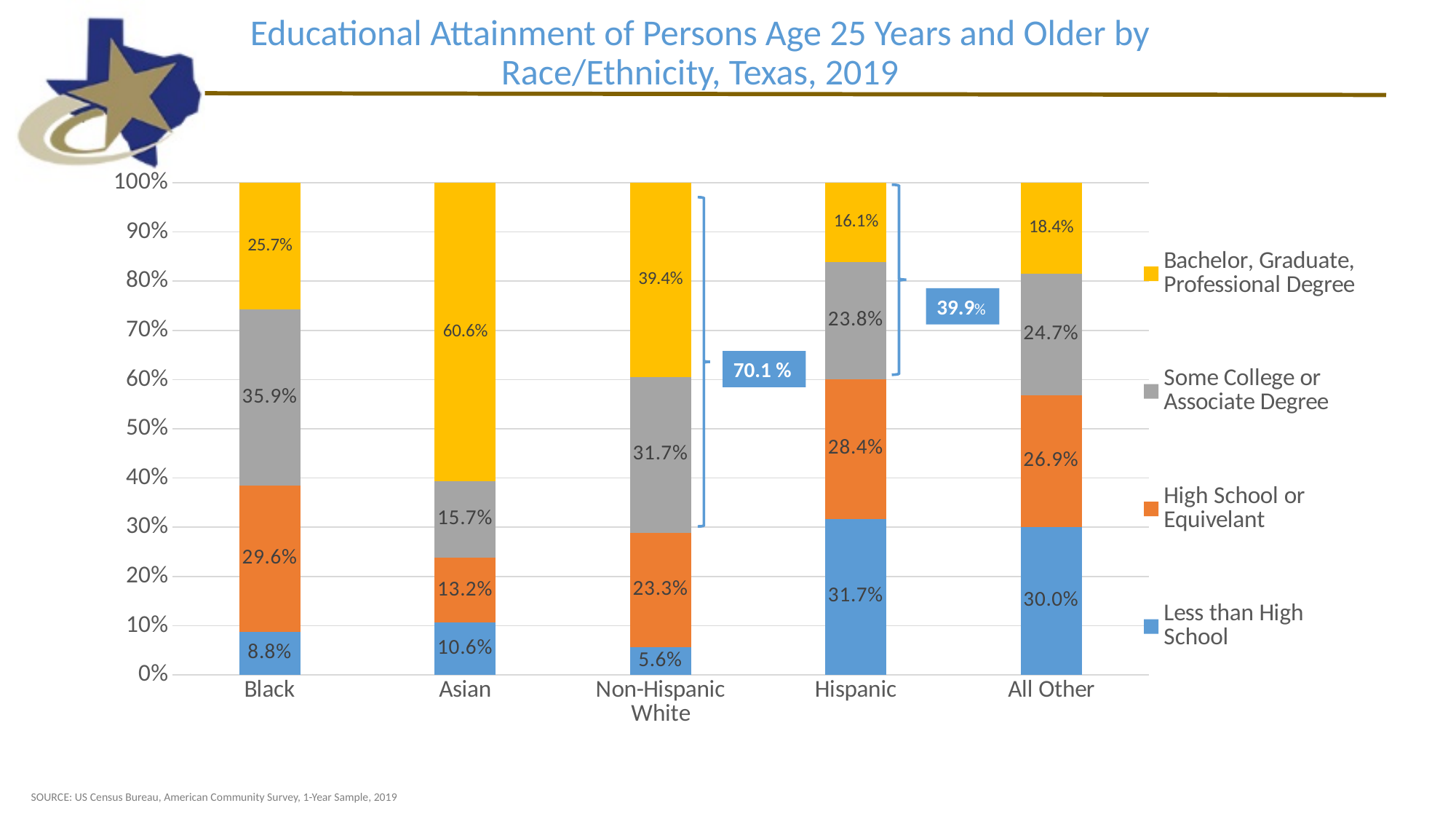
Which has a larger High School or Equivelant share, Hispanic or All Other? Hispanic What is the difference between the Bachelor, Graduate, Professional Degree values for Non-Hispanic White and Hispanic? 23.3 percentage points What kind of chart is shown on the slide? Stacked bar chart What is the Less than High School value for Hispanic persons? 31.7% How many race/ethnicity categories are shown on the x axis? 5 How many education levels does the legend list? 4 Which education level is the largest segment of the Black bar? Some College or Associate Degree What percentage of Asian persons age 25 and older have a Bachelor, Graduate, or Professional Degree? 60.6% Which race/ethnicity category has the highest share with a Bachelor, Graduate, or Professional Degree? Asian What is the difference between the Some College or Associate Degree values for Black (35.9%) and Asian (15.7%)? 20.2 percentage points What is the Some College or Associate Degree value for the All Other category? 24.7% Which race/ethnicity category has the lowest Less than High School share? Non-Hispanic White